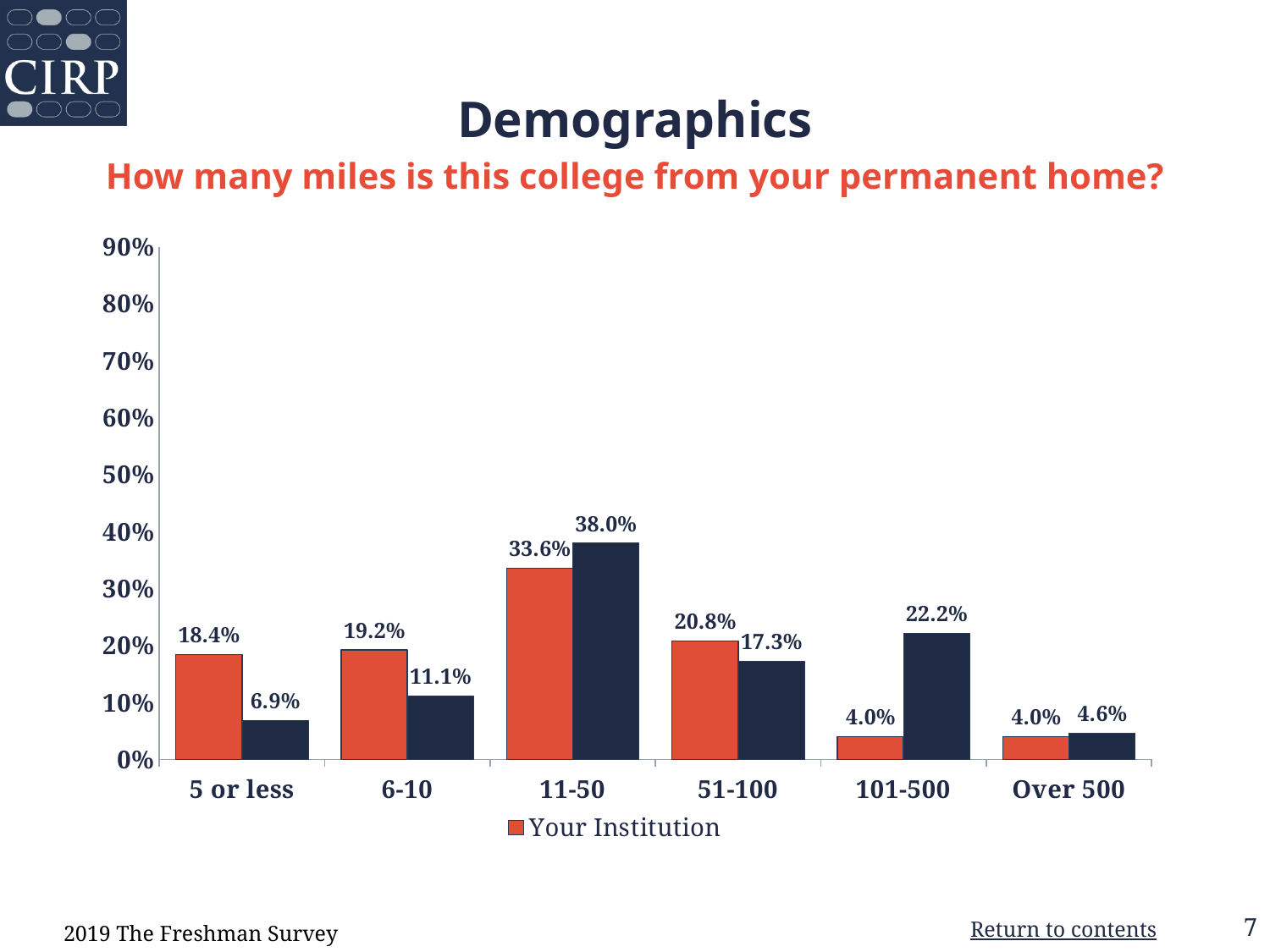
What kind of chart is shown on the slide? Bar chart Is the value for Your Institution in the 11-50 category greater or less than 30%? greater How many series does the legend list? 1 In the 6-10 category, which is larger: the Your Institution bar or the dark blue bar? Your Institution What is the value for Your Institution in the 11-50 category? 33.6% How many distance categories are shown on the x axis? 6 Which category has the highest value for Your Institution? 11-50 What is the value for Your Institution in the 5 or less category? 18.4% What is the value for Your Institution in the 51-100 category? 20.8% What is the value shown by the dark blue bar in the 101-500 category? 22.2% Which category has the lowest value shown by the dark blue bars? Over 500 What is the difference between the dark blue bar and the Your Institution bar in the 101-500 category? 18.2%